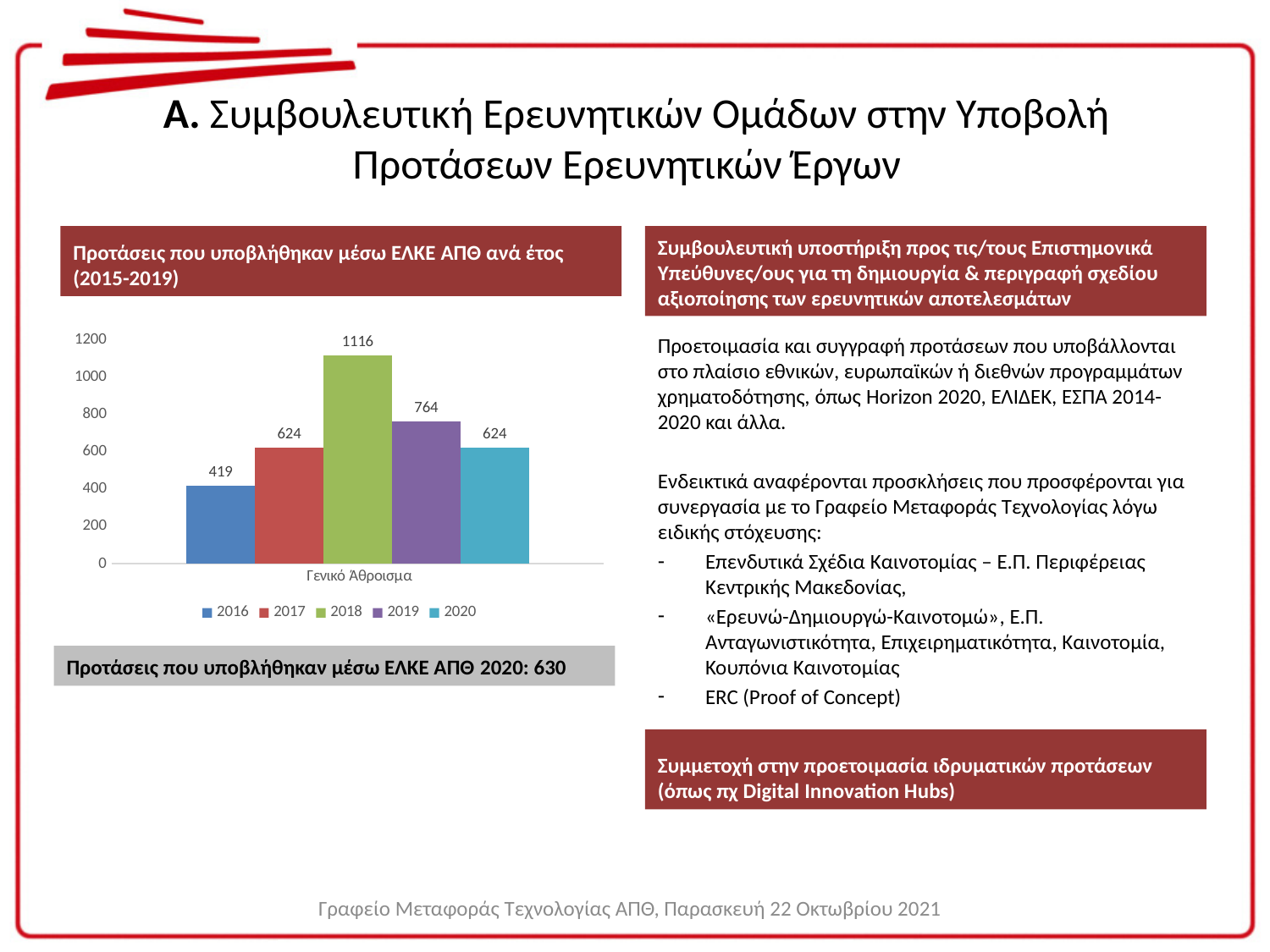
What is the value for 2016 in the bar chart? 419 What colour is the bar for 2018 in the chart? Green What is the value for 2020 in the bar chart? 624 What is the difference between the values for 2018 and 2019? 352 Which year has the lowest value in the bar chart? 2016 What is the value for 2018 in the bar chart? 1116 Which is larger, the value for 2019 or the value for 2017? 2019 How many series does the legend of the bar chart list? 5 What is the value for 2019 in the bar chart? 764 What is the difference between the values for 2017 and 2016? 205 What kind of chart is shown on the slide? Bar chart Which year has the highest value in the bar chart? 2018